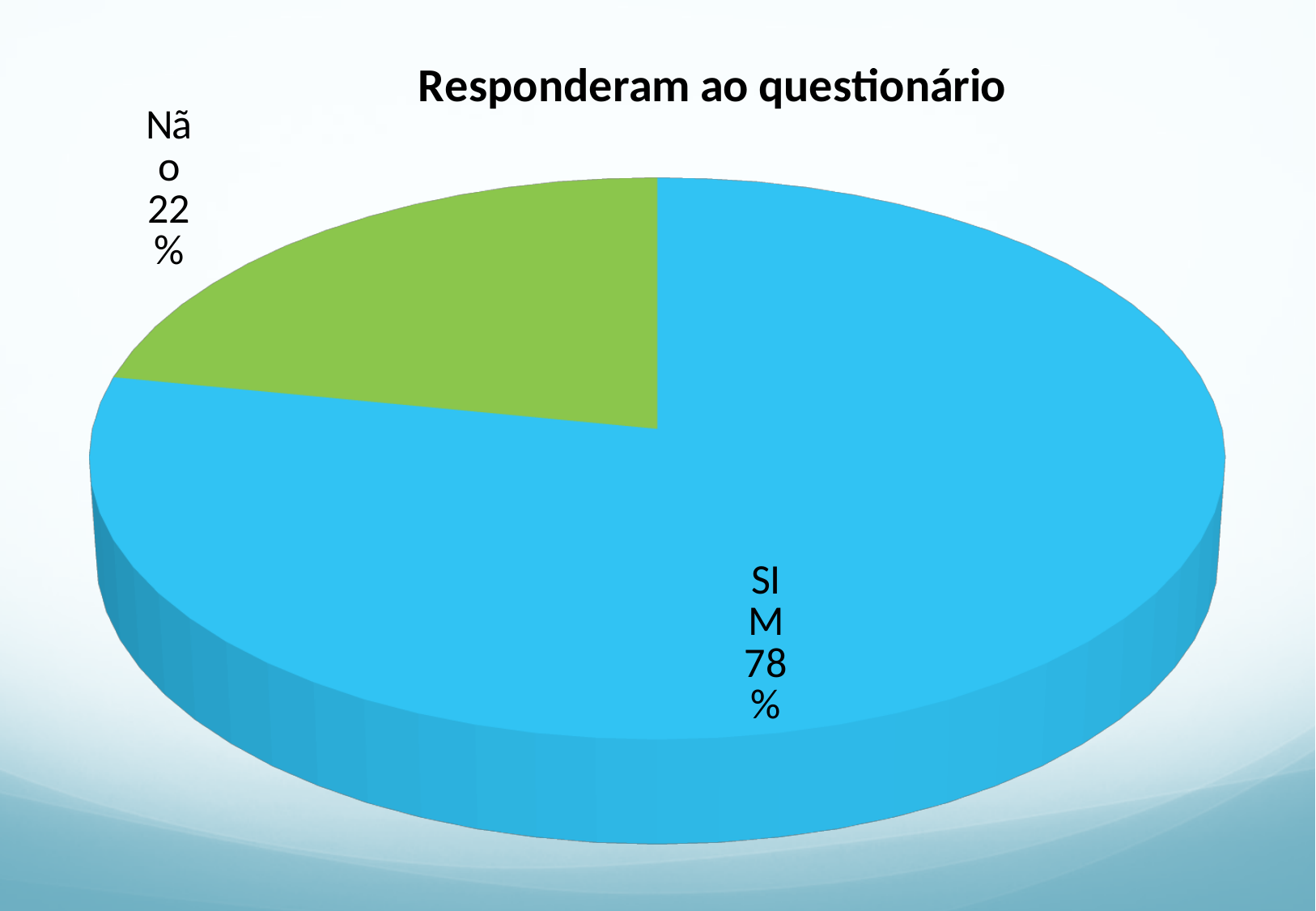
What share of the pie does the Não slice represent? 22% What percentage of the pie is labelled SIM? 78% What type of chart is shown on the slide? pie chart Which slice is the smallest? Não How many slices does the pie chart have? 2 What colour is the SIM slice? blue Which slice is the largest? SIM What percentage of the pie is labelled Não? 22% Which is larger, the SIM slice or the Não slice? SIM What is the title of the chart? Responderam ao questionário What is the difference in percentage points between the SIM and Não slices? 56